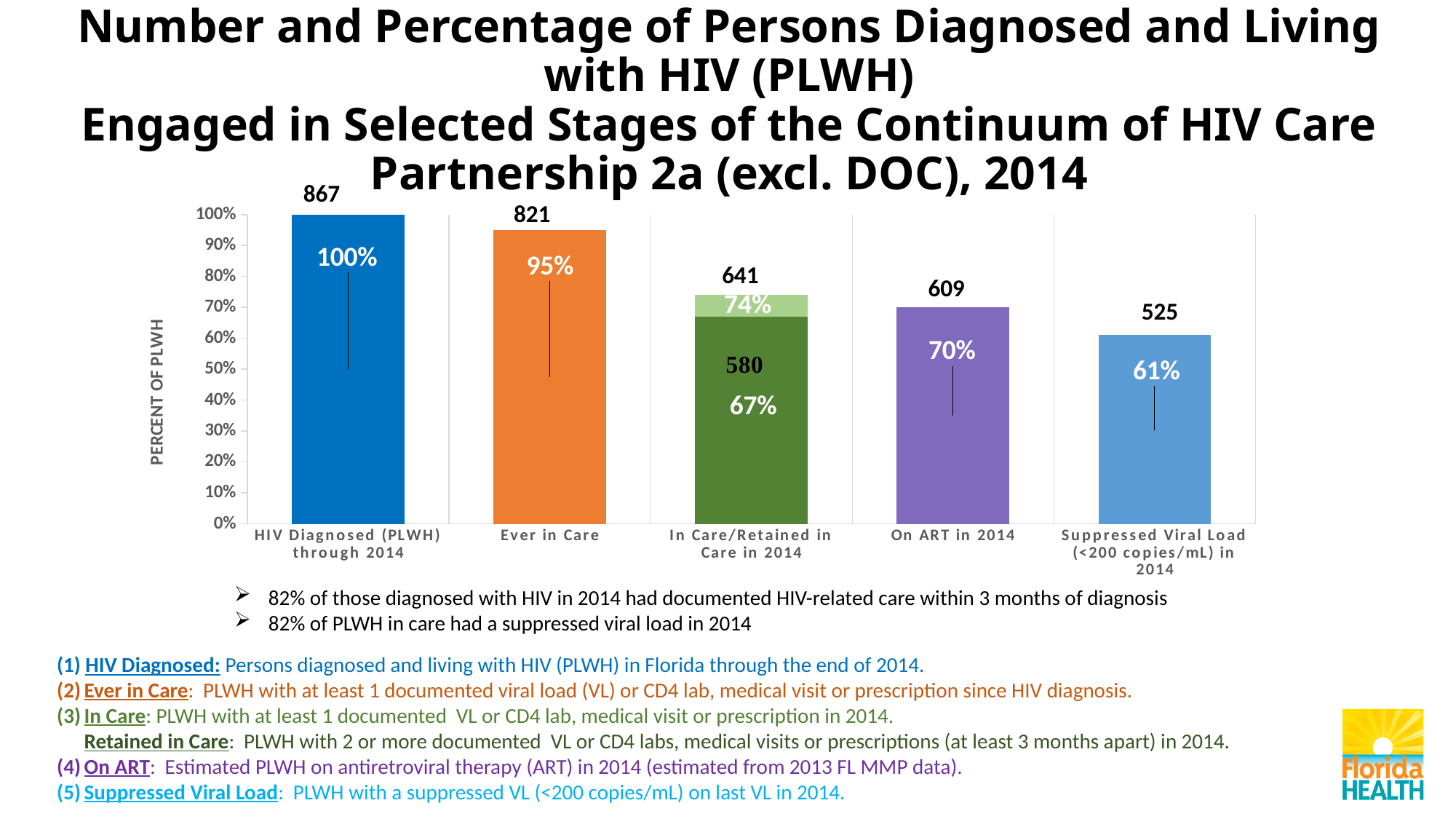
What percentage is shown for Retained in Care in 2014 (the darker green portion of the In Care/Retained in Care bar)? 67% Which stage has the highest percentage of PLWH? HIV Diagnosed (PLWH) through 2014 Do the percentages rise or fall moving from left to right along the x axis? Fall Which is larger, the percentage for On ART in 2014 or the percentage for Suppressed Viral Load in 2014? On ART in 2014 How many stages of the continuum of care are shown on the x axis? 5 Which stage has the lowest percentage of PLWH? Suppressed Viral Load (<200 copies/mL) in 2014 What percentage is shown for Suppressed Viral Load (<200 copies/mL) in 2014? 61% What kind of chart is shown on the slide? Bar chart What is the difference in number of persons between Ever in Care (821) and On ART in 2014 (609)? 212 What number is printed above the HIV Diagnosed (PLWH) through 2014 bar? 867 What number is printed above the On ART in 2014 bar? 609 What percentage is shown for the Ever in Care bar? 95%